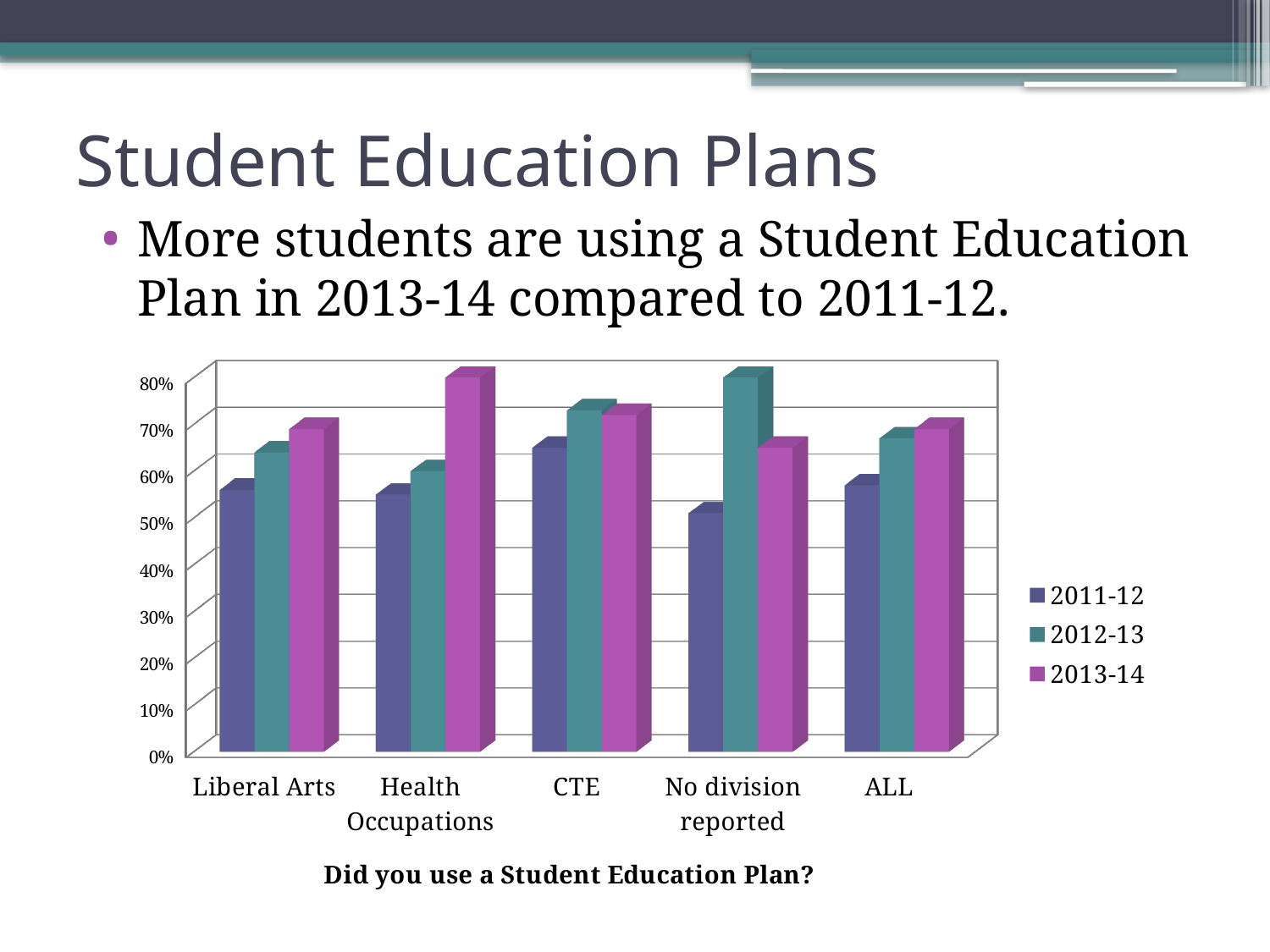
Is the value for No division reported in 2011-12 greater or less than 60%? less Which category has the highest value for the 2013-14 series? Health Occupations Which series is shown in purple/magenta in the chart? 2013-14 Which category has the lowest value for the 2011-12 series? No division reported How many categories are shown on the x axis of the chart? 5 Is the value for Health Occupations in 2013-14 greater or less than 70%? greater Which category has the highest value for the 2012-13 series? No division reported What question is written as the chart's title below the x axis? Did you use a Student Education Plan? For Liberal Arts, do the values rise or fall from 2011-12 to 2013-14? rise How many series does the chart's legend list? 3 What kind of chart is shown on the slide? Bar chart For No division reported, which is larger: the 2012-13 value or the 2013-14 value? 2012-13